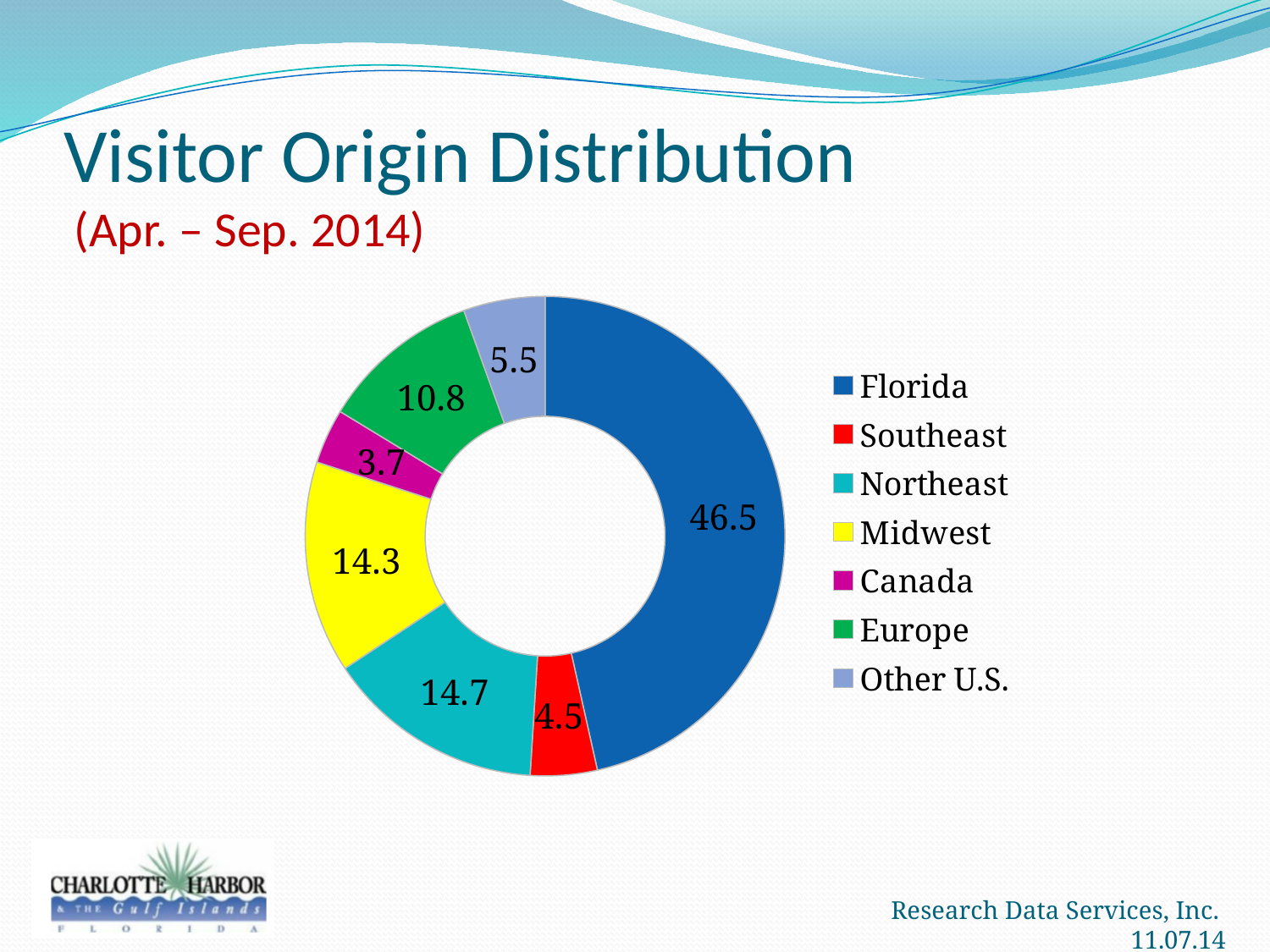
Which colour represents Midwest in the chart legend? Yellow What kind of chart is used to show the Visitor Origin Distribution? Doughnut chart Which visitor origin has the largest value in the chart? Florida Which visitor origin has the smallest value in the chart? Canada What is the value shown for Europe in the chart? 10.8 What is the value shown for Canada in the chart? 3.7 What is the difference between the values for Florida and Northeast? 31.8 How many visitor origin categories are shown in the chart? 7 What is the value shown for Other U.S. in the chart? 5.5 What is the difference between the values for Europe and Other U.S.? 5.3 What is the value shown for Florida in the Visitor Origin Distribution chart? 46.5 Which has a larger value, Southeast or Europe? Europe